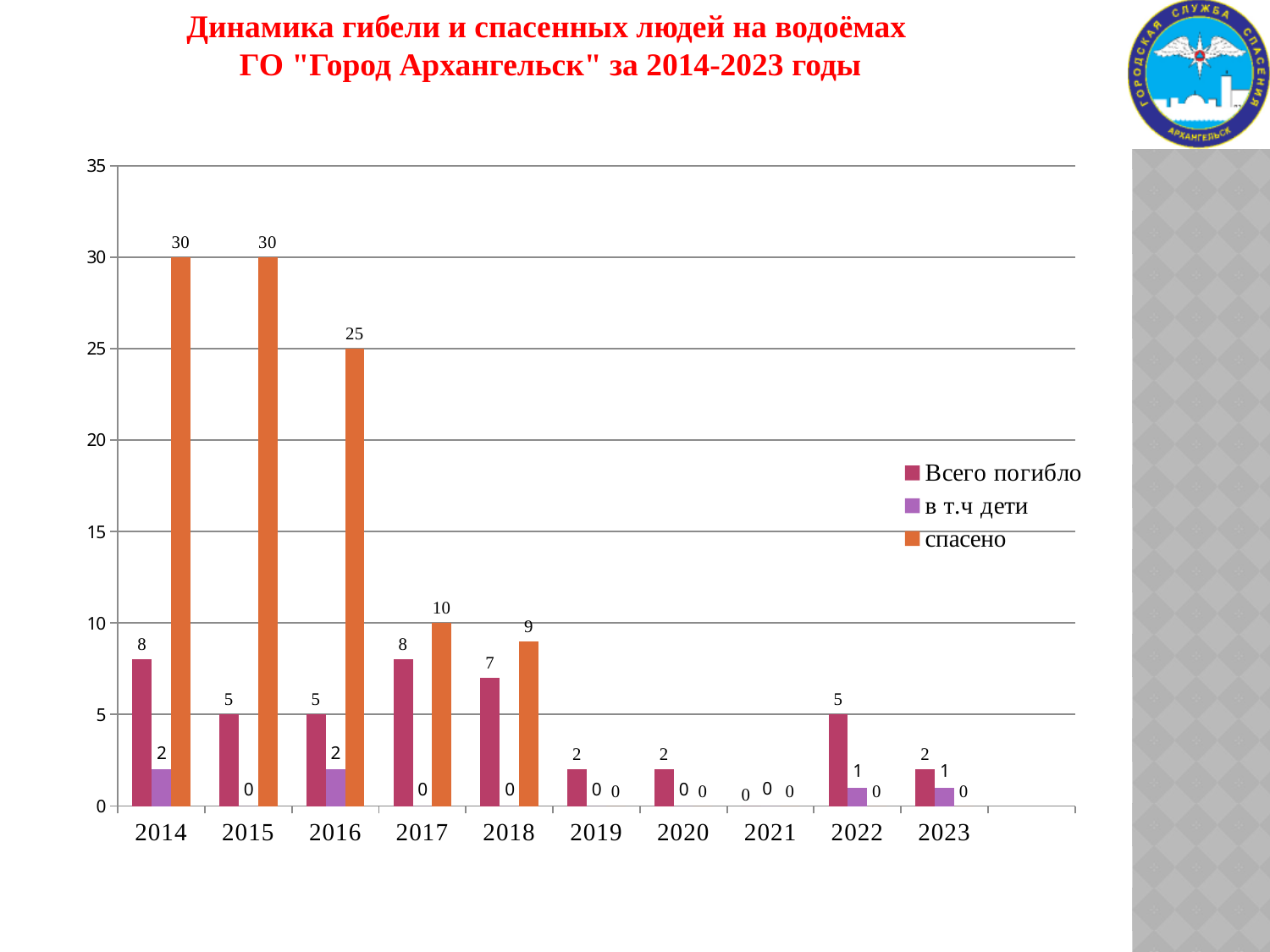
Is the value of "спасено" for 2015 greater or less than 25? greater Which colour represents the "в т.ч дети" series? purple What is the value of "в т.ч дети" for 2022? 1 Does the "спасено" series rise or fall from 2014 to 2019? fall What is the value of "Всего погибло" for 2018? 7 How many years are shown on the x axis? 10 How many series does the legend list? 3 What is the difference between "спасено" in 2014 and "спасено" in 2017? 20 What type of chart is shown on the slide? bar chart What is the value of "спасено" for 2016? 25 Which is larger: "Всего погибло" in 2017 or "Всего погибло" in 2022? 2017 In which year is the value of "спасено" lowest among 2014–2018? 2018